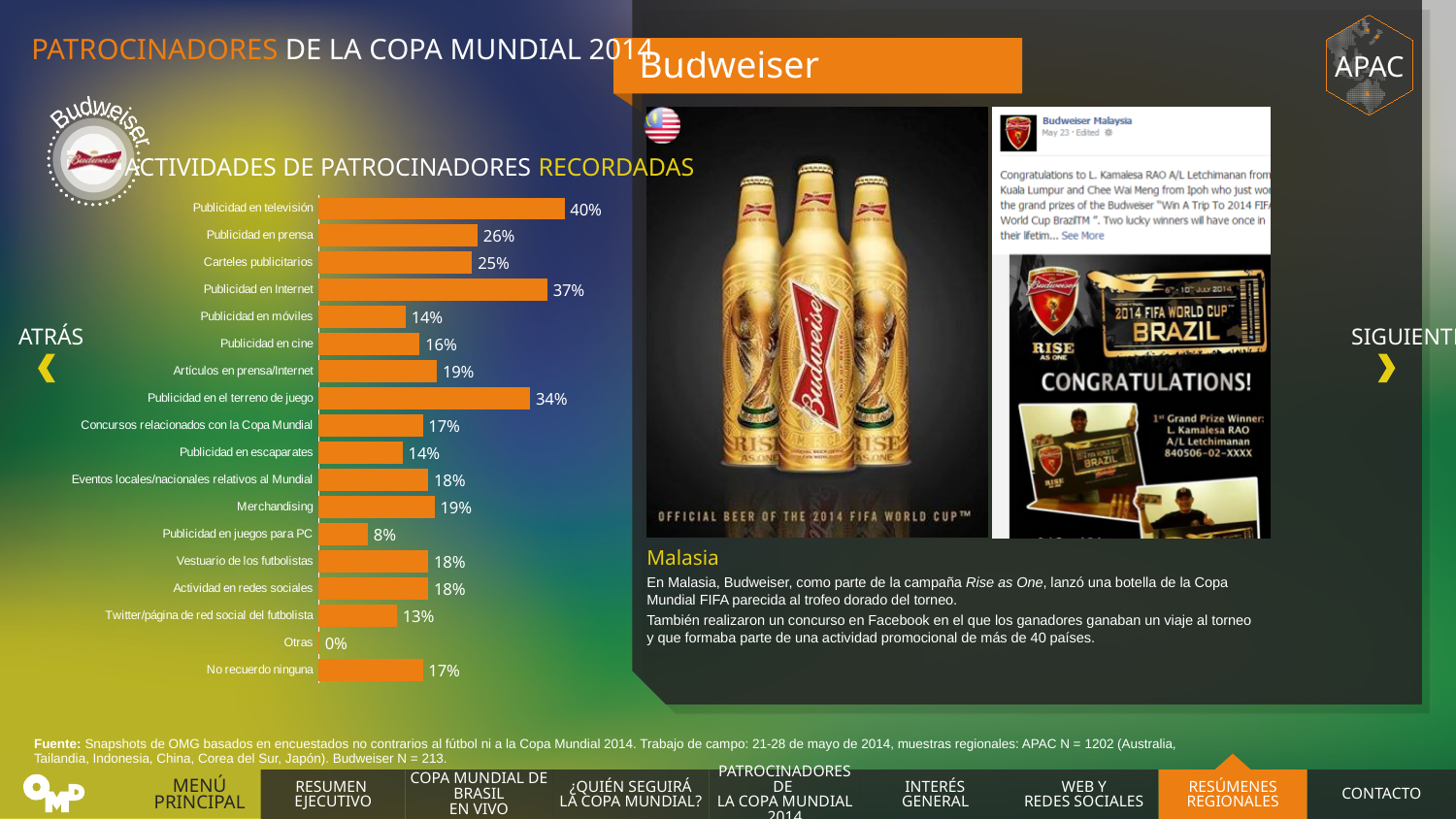
Which category has the highest value? Publicidad en televisión What is the title of the chart? ACTIVIDADES DE PATROCINADORES RECORDADAS What is the difference between Publicidad en televisión and Publicidad en Internet? 3% What kind of chart is shown on the slide? Bar chart Which is larger, Publicidad en prensa or Carteles publicitarios? Publicidad en prensa How many categories are shown in the chart? 18 What is the value for Publicidad en juegos para PC? 8% Which category has the lowest value? Otras What is the difference between Merchandising and Twitter/página de red social del futbolista? 6% What is the value for Publicidad en televisión? 40% What is the value for No recuerdo ninguna? 17% What is the value for Publicidad en el terreno de juego? 34%